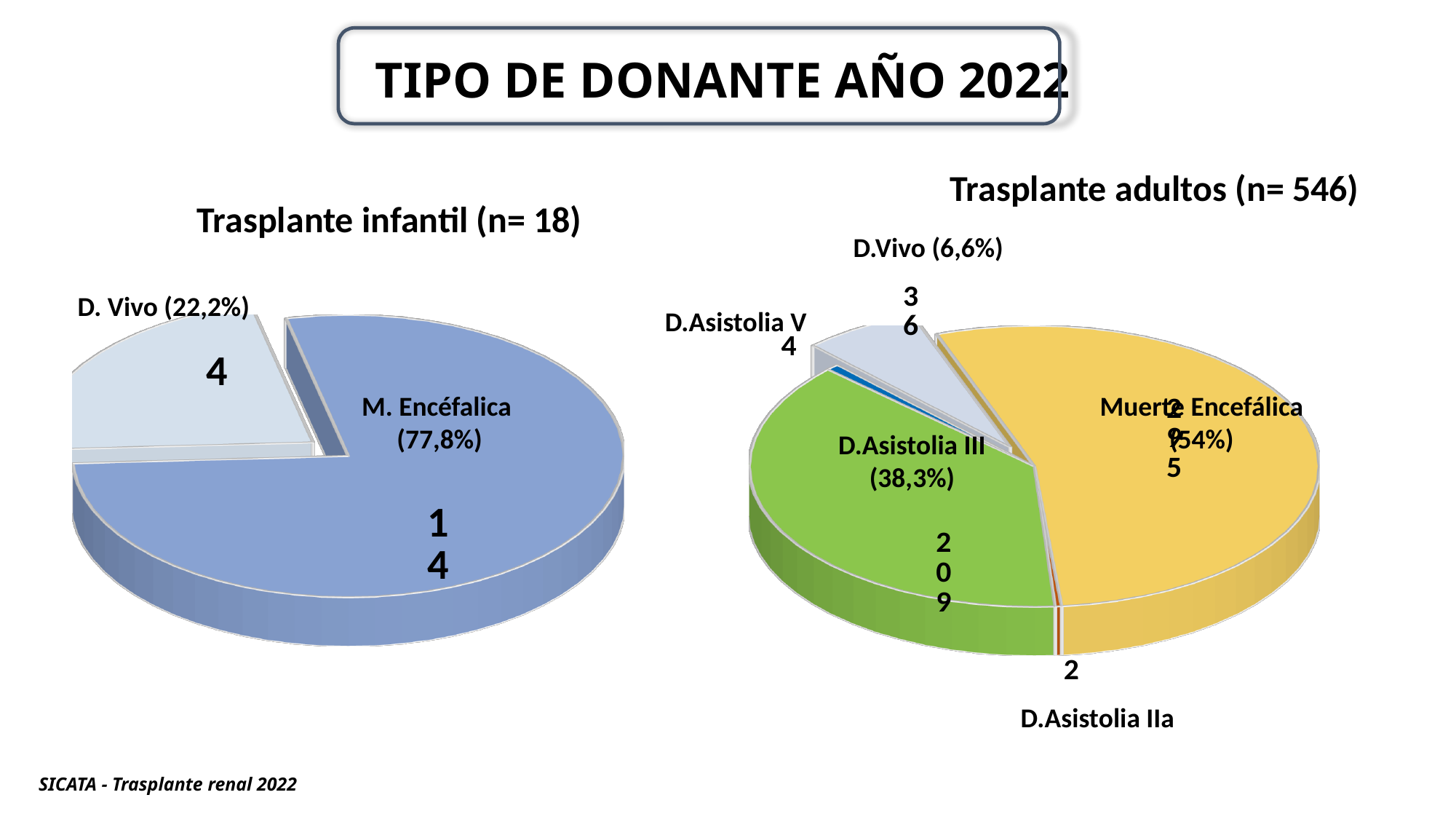
In the 'Trasplante adultos (n= 546)' chart, how many categories are shown? 5 In the 'Trasplante infantil (n= 18)' chart, what is the difference between M. Encéfalica and D. Vivo? 10 In the 'Trasplante infantil (n= 18)' chart, what is the value for M. Encéfalica? 14 In the 'Trasplante adultos (n= 546)' chart, which is larger, D.Vivo or D.Asistolia V? D.Vivo In the 'Trasplante adultos (n= 546)' chart, what is the value for D.Asistolia III? 209 In the 'Trasplante adultos (n= 546)' chart, which category has the smallest value? D.Asistolia IIa In the 'Trasplante adultos (n= 546)' chart, what share of the pie does Muerte Encefálica represent? 54% In the 'Trasplante infantil (n= 18)' chart, what is the value for D. Vivo? 4 What kind of chart is the 'Trasplante infantil (n= 18)' chart? Pie chart In the 'Trasplante adultos (n= 546)' chart, what is the value for D.Vivo? 36 In the 'Trasplante infantil (n= 18)' chart, what share of the pie does M. Encéfalica represent? 77,8% In the 'Trasplante adultos (n= 546)' chart, what is the value for D.Asistolia IIa? 2